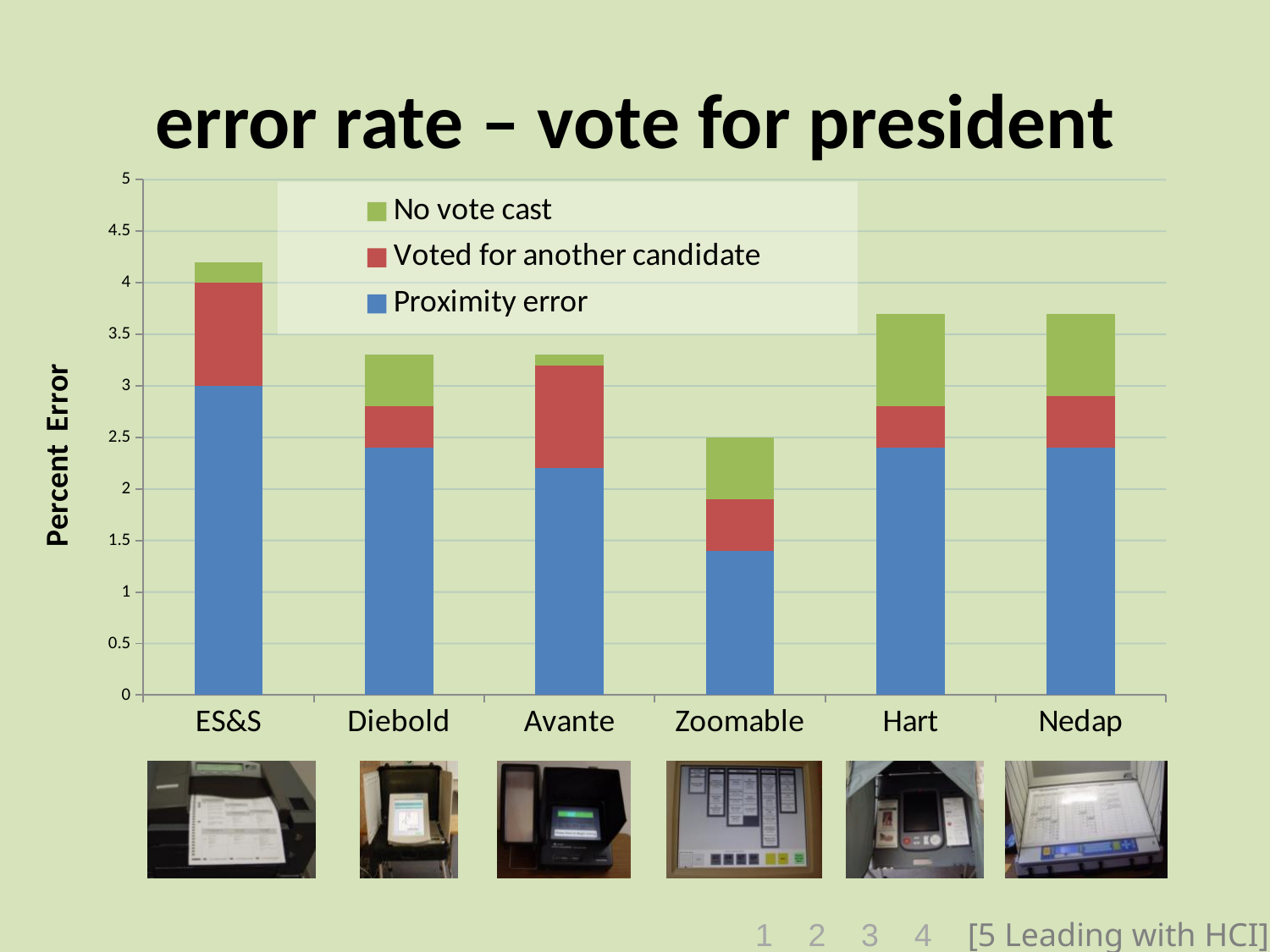
Which voting system has the lowest total percent error? Zoomable Is the total percent error for ES&S greater or less than 4? greater Which has the larger total percent error, Diebold or Zoomable? Diebold Which voting system has the lowest Proximity error? Zoomable What is the Proximity error value for ES&S? 3 What kind of chart is shown on the slide? stacked bar chart How many series does the legend list? 3 What is the total percent error for Zoomable? 2.5 Which series is shown in green in the legend? No vote cast Which voting system has the highest total percent error? ES&S What is the title of the chart? error rate – vote for president How many voting systems (categories) are shown on the x axis? 6